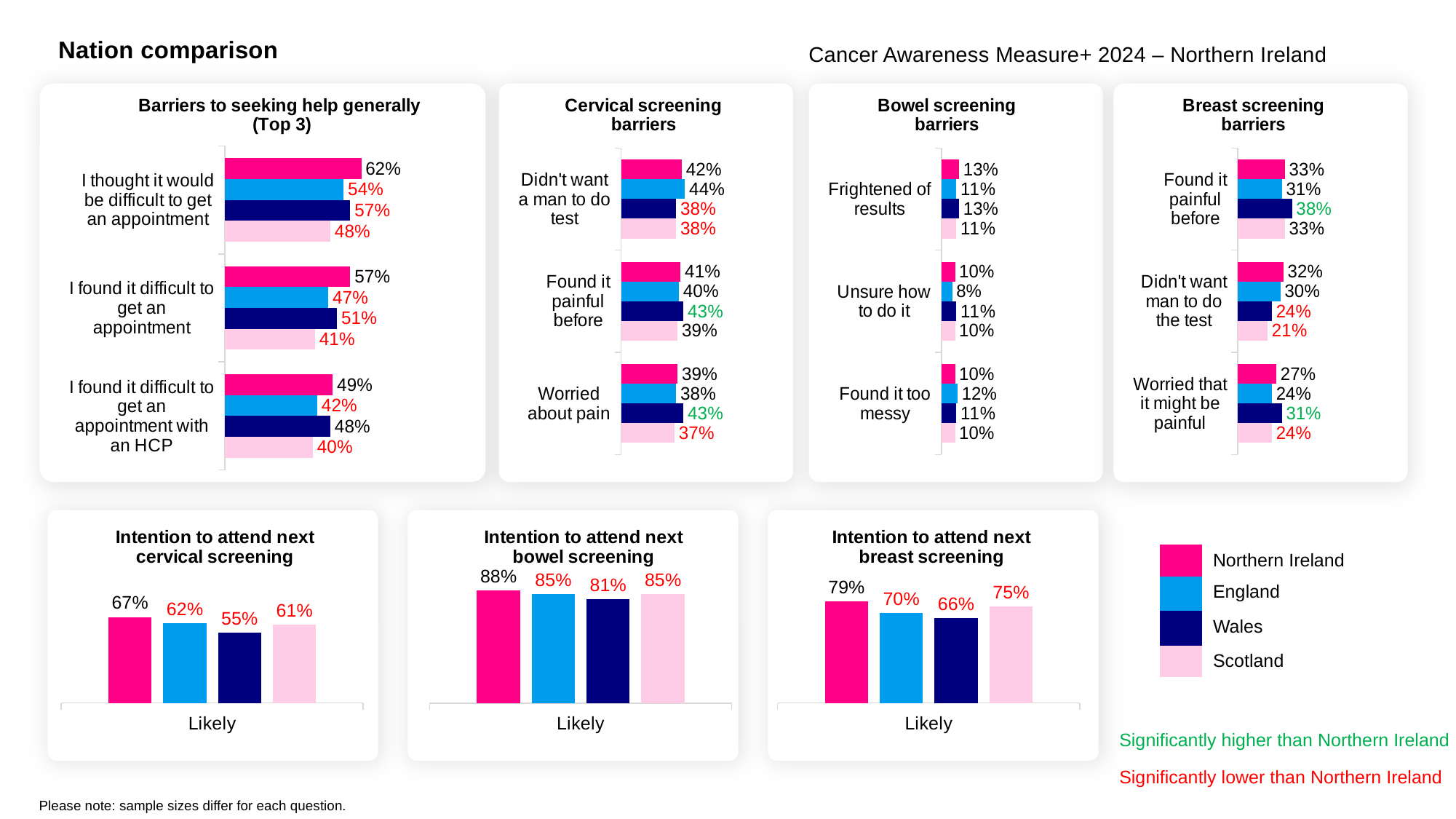
In the 'Breast screening barriers' chart, what is the Scotland value for 'Didn't want man to do the test'? 21% In the 'Intention to attend next bowel screening' chart, what is the difference between the Northern Ireland value and the Wales value? 7% In the 'Breast screening barriers' chart, which nation has the highest value for 'Found it painful before'? Wales In the 'Barriers to seeking help generally (Top 3)' chart, what is the Northern Ireland value for 'I thought it would be difficult to get an appointment'? 62% What kind of chart is the 'Intention to attend next cervical screening' chart? Bar chart In the 'Bowel screening barriers' chart, what is the England value for 'Unsure how to do it'? 8% In the 'Intention to attend next cervical screening' chart, which nation has the lowest value? Wales How many nations does the legend list? 4 In the 'Cervical screening barriers' chart, what is the Wales value for 'Found it painful before'? 43% In the 'Intention to attend next breast screening' chart, which is larger: the England value or the Scotland value? Scotland Which nation is represented by the dark blue bars in the legend? Wales How many categories are shown in the 'Bowel screening barriers' chart? 3